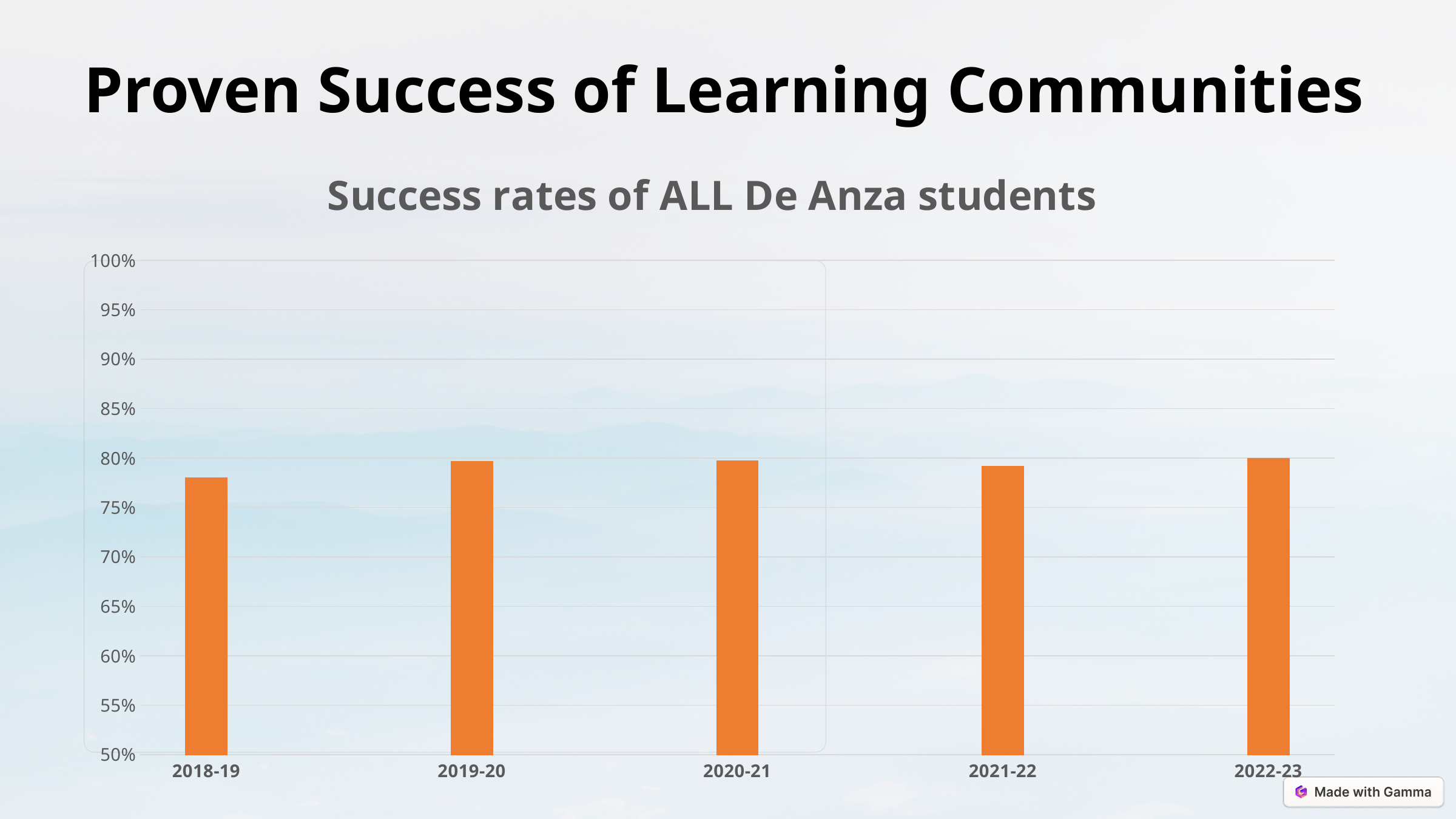
Is the success rate for 2018-19 greater or less than 75%? greater Is the success rate for 2018-19 greater or less than 80%? less What is the lowest value shown on the y axis of the chart? 50% Which has the higher success rate, 2018-19 or 2022-23? 2022-23 What is the title of the chart? Success rates of ALL De Anza students Is the success rate for 2021-22 greater or less than 80%? less How many academic years are shown on the x axis of the chart? 5 Which has the higher success rate, 2018-19 or 2019-20? 2019-20 What colour are the bars in the chart? orange What kind of chart is shown on the slide? bar chart Which academic year has the lowest success rate? 2018-19